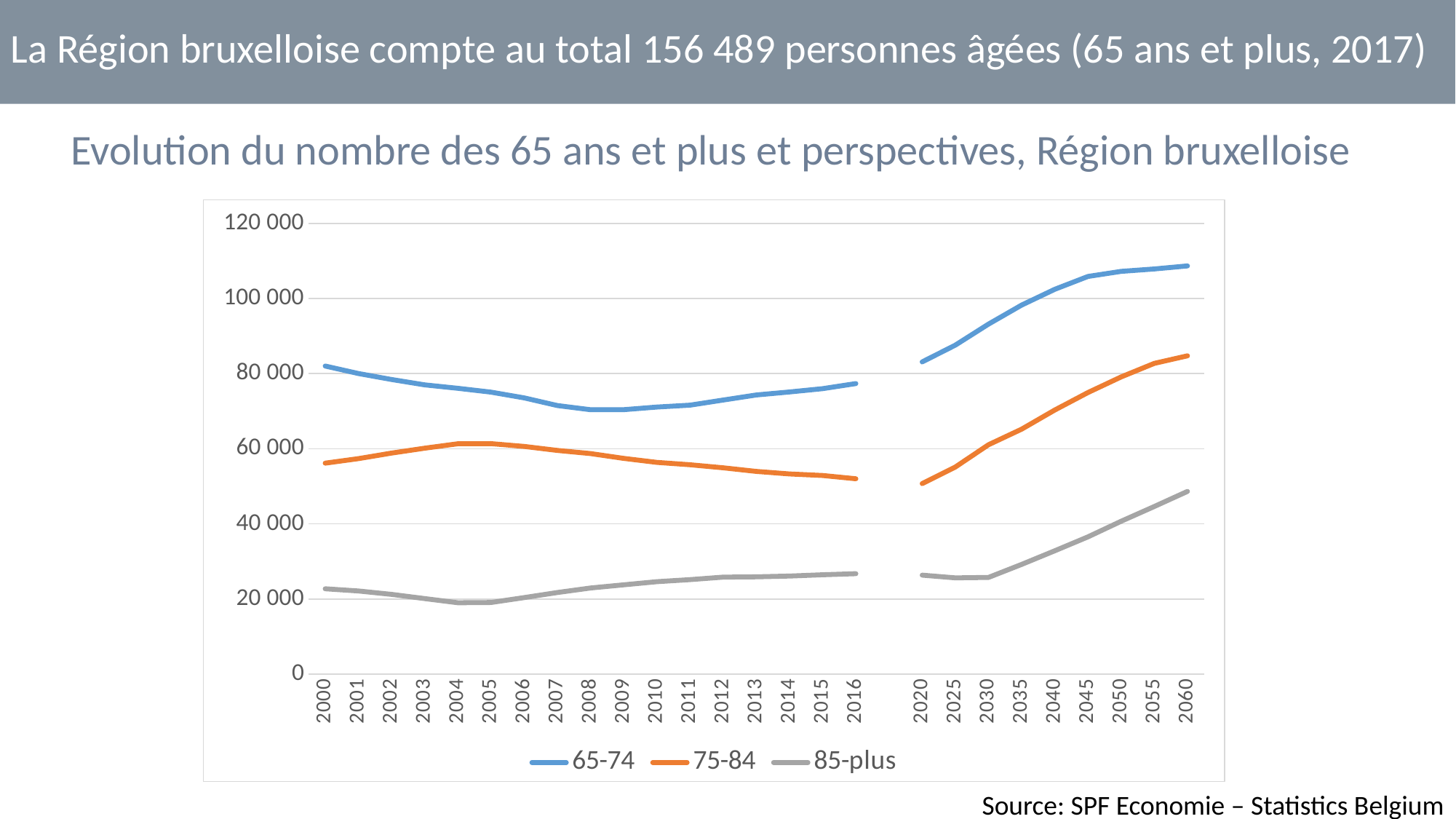
Is the value for 65-74 in 2000 greater or less than 80 000? greater Does the 65-74 series rise or fall between 2000 and 2008? fall Is the value for 65-74 in 2060 greater or less than 100 000? greater How many series does the legend list? 3 Which is larger in 2016: the value for 65-74 or the value for 75-84? 65-74 What kind of chart is shown on the slide? line chart Which series has the highest value in 2060? 65-74 What is the title of the chart? Evolution du nombre des 65 ans et plus et perspectives, Région bruxelloise Is the value for 75-84 in 2016 greater or less than 60 000? less Does the 85-plus series rise or fall between 2030 and 2060? rise Which series has the lowest value in 2000? 85-plus